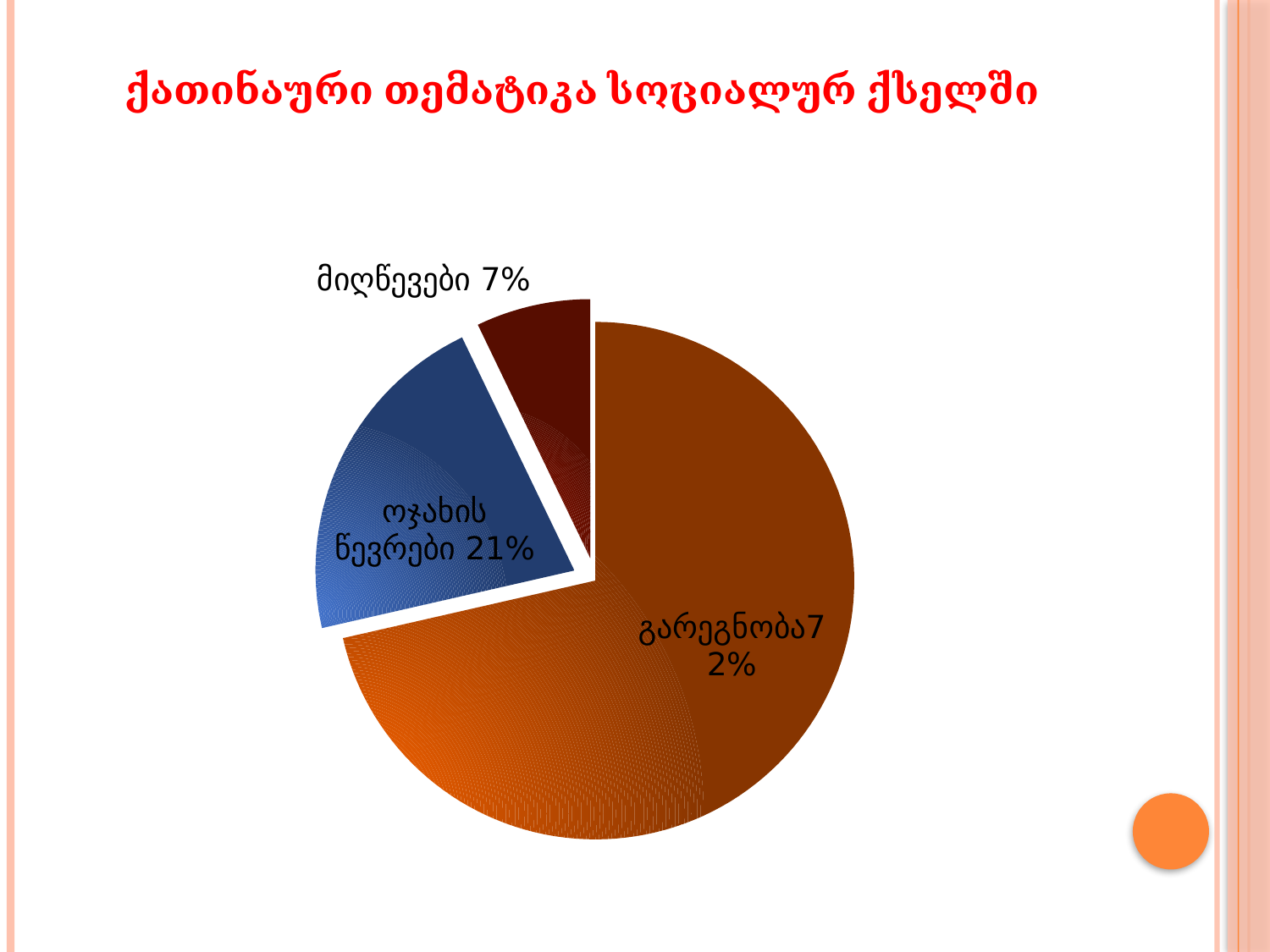
What is the title of the chart on the slide? ქათინაური თემატიკა სოციალურ ქსელში What share of the pie does გარეგნობა take? 72% What is the difference in percentage points between ოჯახის წევრები and მიღწევები? 14 How many slices does the pie chart have? 3 Which category has the smallest slice of the pie? მიღწევები Which is larger, the slice for ოჯახის წევრები or the slice for მიღწევები? ოჯახის წევრები What share of the pie does მიღწევები take? 7% Which category has the largest slice of the pie? გარეგნობა What is the difference in percentage points between გარეგნობა and ოჯახის წევრები? 51 What kind of chart is shown on the slide? pie chart What share of the pie does ოჯახის წევრები take? 21% What colour is the slice for ოჯახის წევრები? blue